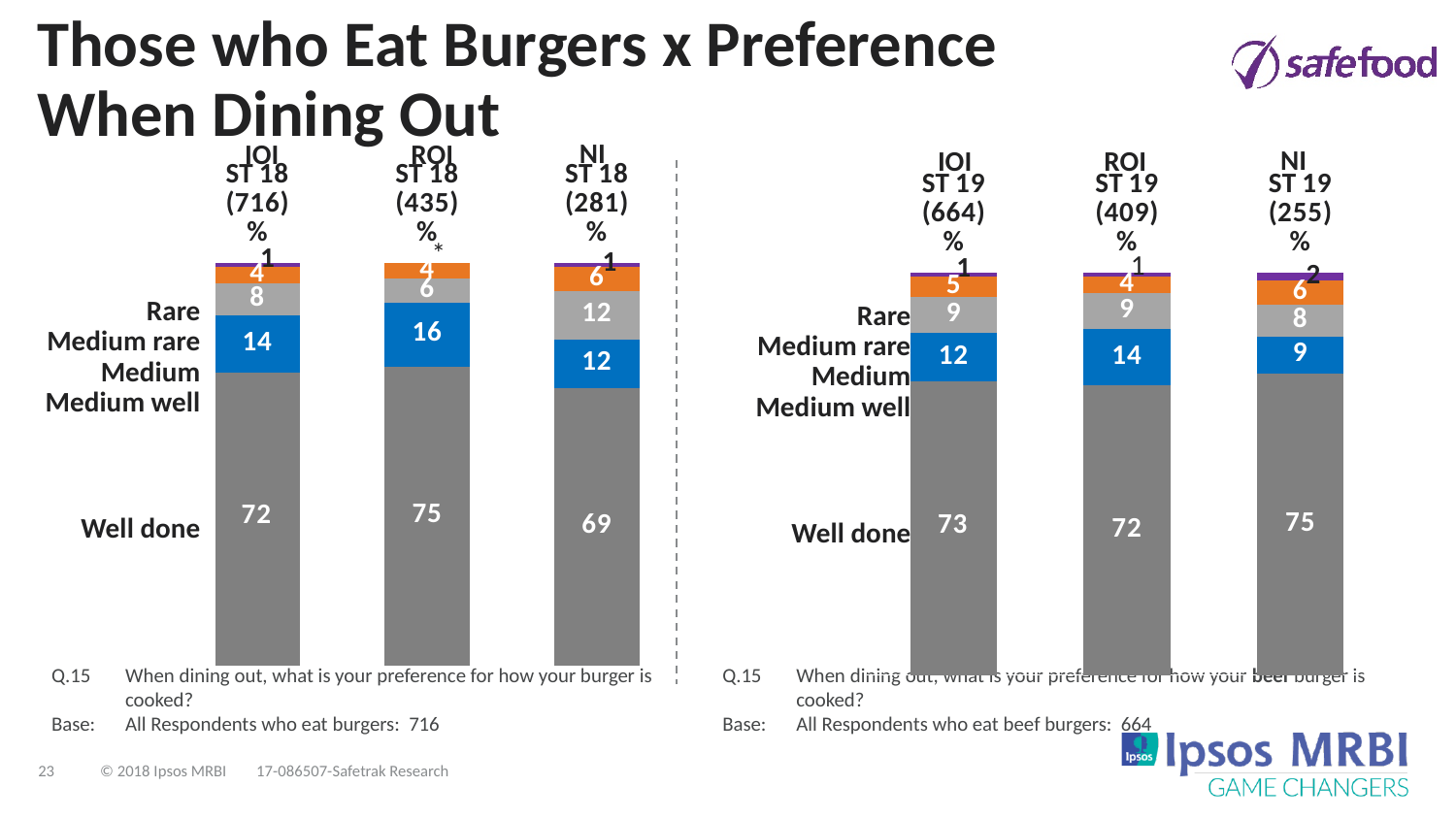
In the left chart (ST 18), which bar has the lowest Well done value? NI ST 18 In the left chart (ST 18), what percentage of NI ST 18 respondents prefer their burger well done? 69 In the right chart (ST 19), what is the difference between the Well done values for IOI ST 19 and ROI ST 19? 1 In the right chart (ST 19), which bar has the highest Well done value? NI ST 19 How many bars are shown in the left chart (ST 18)? 3 In the right chart (ST 19), what is the Well done value for NI ST 19? 75 In the left chart (ST 18), what is the Medium value for NI ST 18? 12 In the left chart (ST 18), what is the Medium well value for ROI ST 18? 16 In the right chart (ST 19), what is the Medium well value for IOI ST 19? 12 In the left chart (ST 18), which bar has the highest Well done value? ROI ST 18 In the left chart (ST 18), which is larger, the Medium well value for IOI ST 18 or for NI ST 18? IOI ST 18 What type of chart is used on this slide? Stacked bar chart